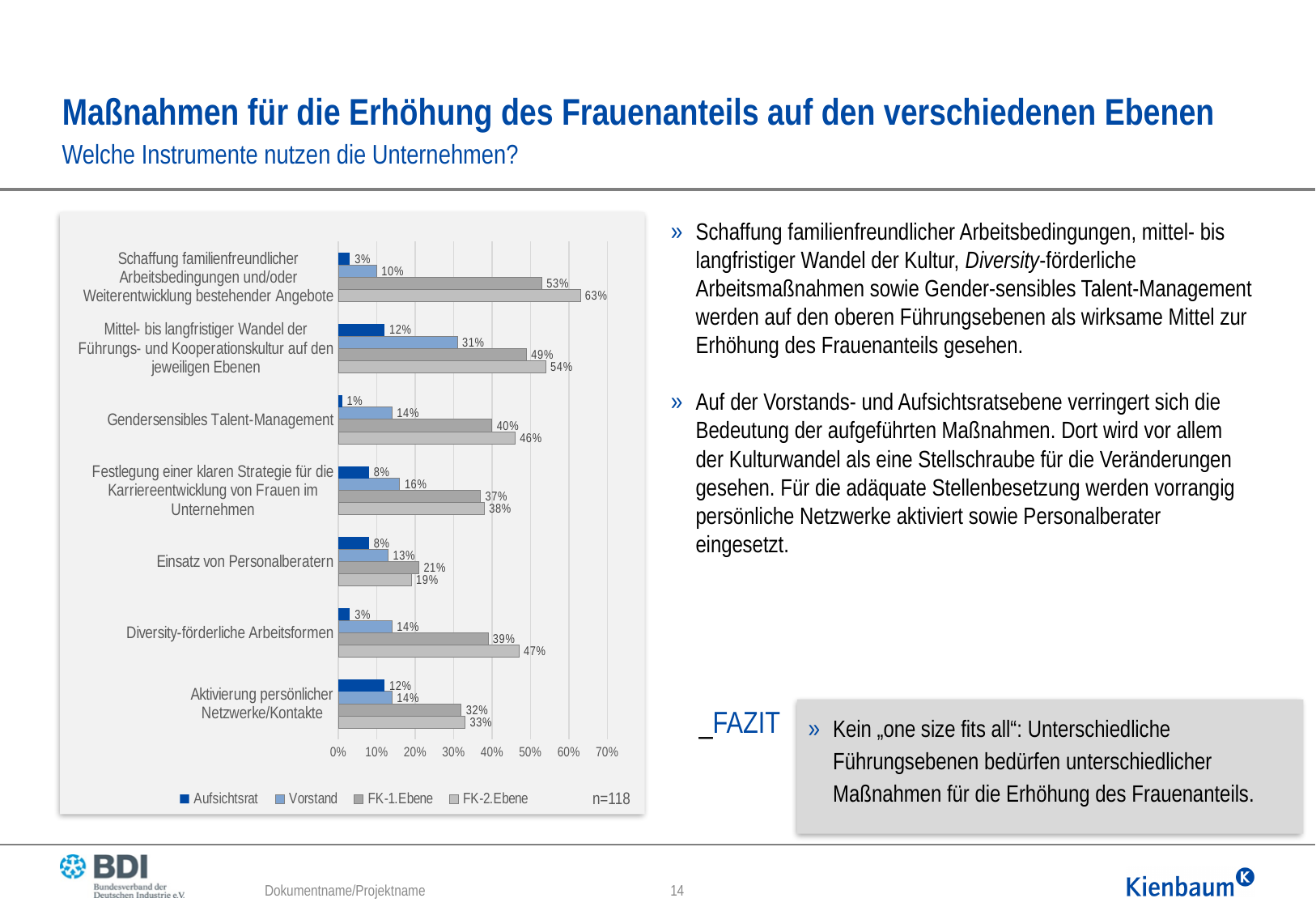
How many categories (measures) are shown in the chart? 7 For "Einsatz von Personalberatern", which is larger: the FK-1.Ebene value or the FK-2.Ebene value? FK-1.Ebene What is the Aufsichtsrat value for "Gendersensibles Talent-Management"? 1% What is the Vorstand value for "Mittel- bis langfristiger Wandel der Führungs- und Kooperationskultur auf den jeweiligen Ebenen"? 31% How many series does the chart legend list? 4 What is the difference between the FK-2.Ebene and Aufsichtsrat values for "Diversity-förderliche Arbeitsformen"? 44% Which category has the lowest FK-1.Ebene value? Einsatz von Personalberatern What kind of chart is shown on the slide? bar chart What is the FK-2.Ebene value for "Schaffung familienfreundlicher Arbeitsbedingungen und/oder Weiterentwicklung bestehender Angebote"? 63% What sample size (n) is stated below the chart? n=118 Is the FK-1.Ebene value for "Mittel- bis langfristiger Wandel der Führungs- und Kooperationskultur auf den jeweiligen Ebenen" greater or less than 40%? greater Which category has the highest FK-2.Ebene value? Schaffung familienfreundlicher Arbeitsbedingungen und/oder Weiterentwicklung bestehender Angebote